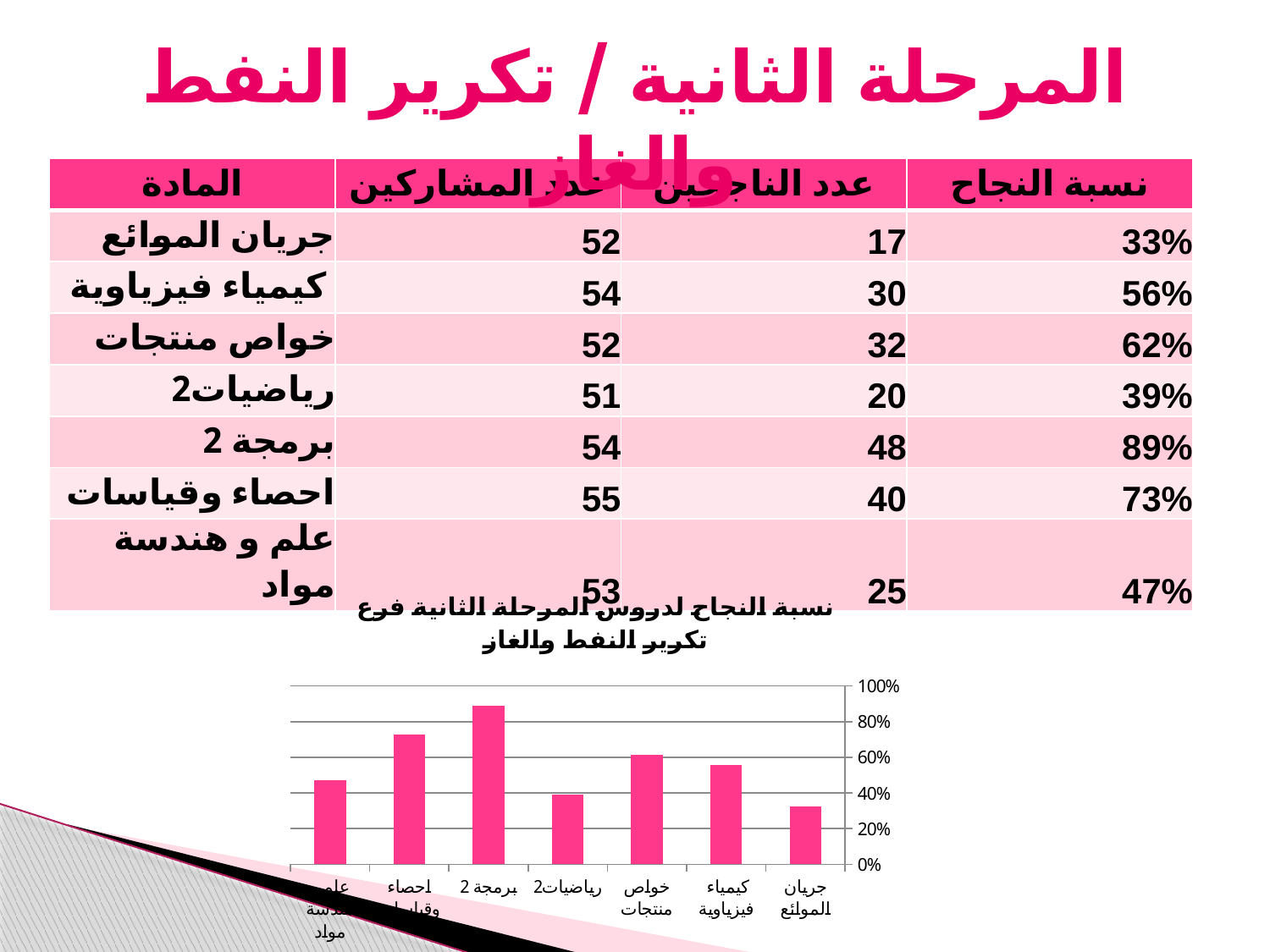
Which subject has the highest bar in the chart? برمجة 2 What is the highest value shown on the chart's vertical axis? 100% Is the value for جريان الموائع in the chart greater or less than 40%? less Which subject has the lowest bar in the chart? جريان الموائع According to the table, what is the success rate (نسبة النجاح) for جريان الموائع? 33% According to the table, what is the success rate (نسبة النجاح) for برمجة 2? 89% Which is larger in the chart, the value for خواص منتجات or the value for رياضيات2? خواص منتجات How many bars does the chart show? 7 What kind of chart is shown on the slide? bar chart Is the value for برمجة 2 in the chart greater or less than 80%? greater Is the value for احصاء وقياسات in the chart greater or less than 60%? greater Which is larger in the chart, the value for كيمياء فيزياوية or the value for احصاء وقياسات? احصاء وقياسات